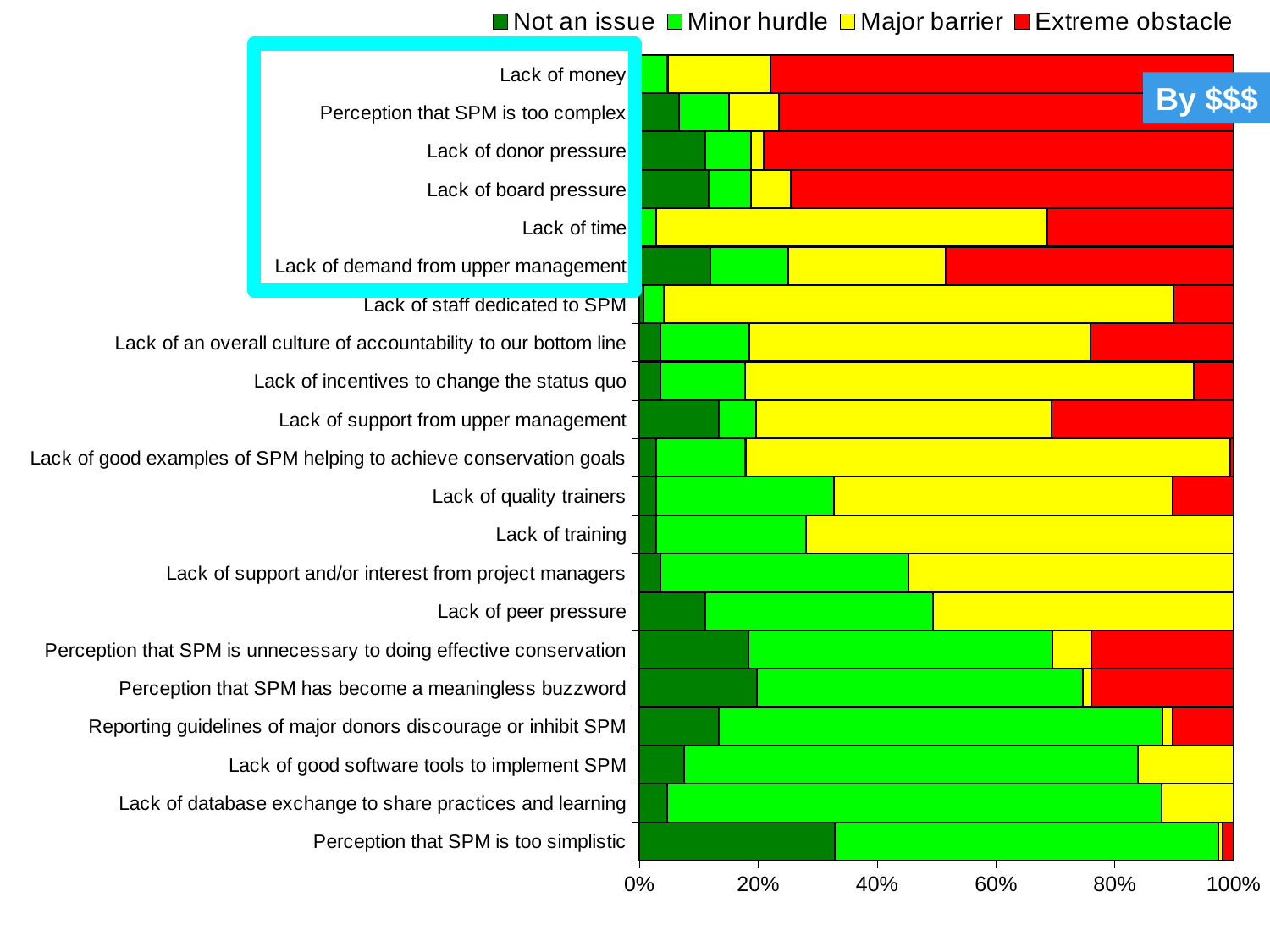
Is the 'Extreme obstacle' share for 'Lack of money' greater or less than 60%? greater Which category has the largest 'Not an issue' share? Perception that SPM is too simplistic Which category has the largest 'Minor hurdle' share? Lack of database exchange to share practices and learning Which has the larger 'Extreme obstacle' share: 'Lack of money' or 'Lack of time'? Lack of money What text appears in the blue label box at the top right of the chart? By $$$ Is the 'Not an issue' share for 'Perception that SPM is too simplistic' greater or less than 20%? greater How many categories (obstacles) are plotted on the chart? 21 What kind of chart is shown on the slide? Stacked bar chart Which series is shown in red in the legend? Extreme obstacle Is the 'Major barrier' share for 'Lack of time' greater or less than 60%? greater How many series does the legend list? 4